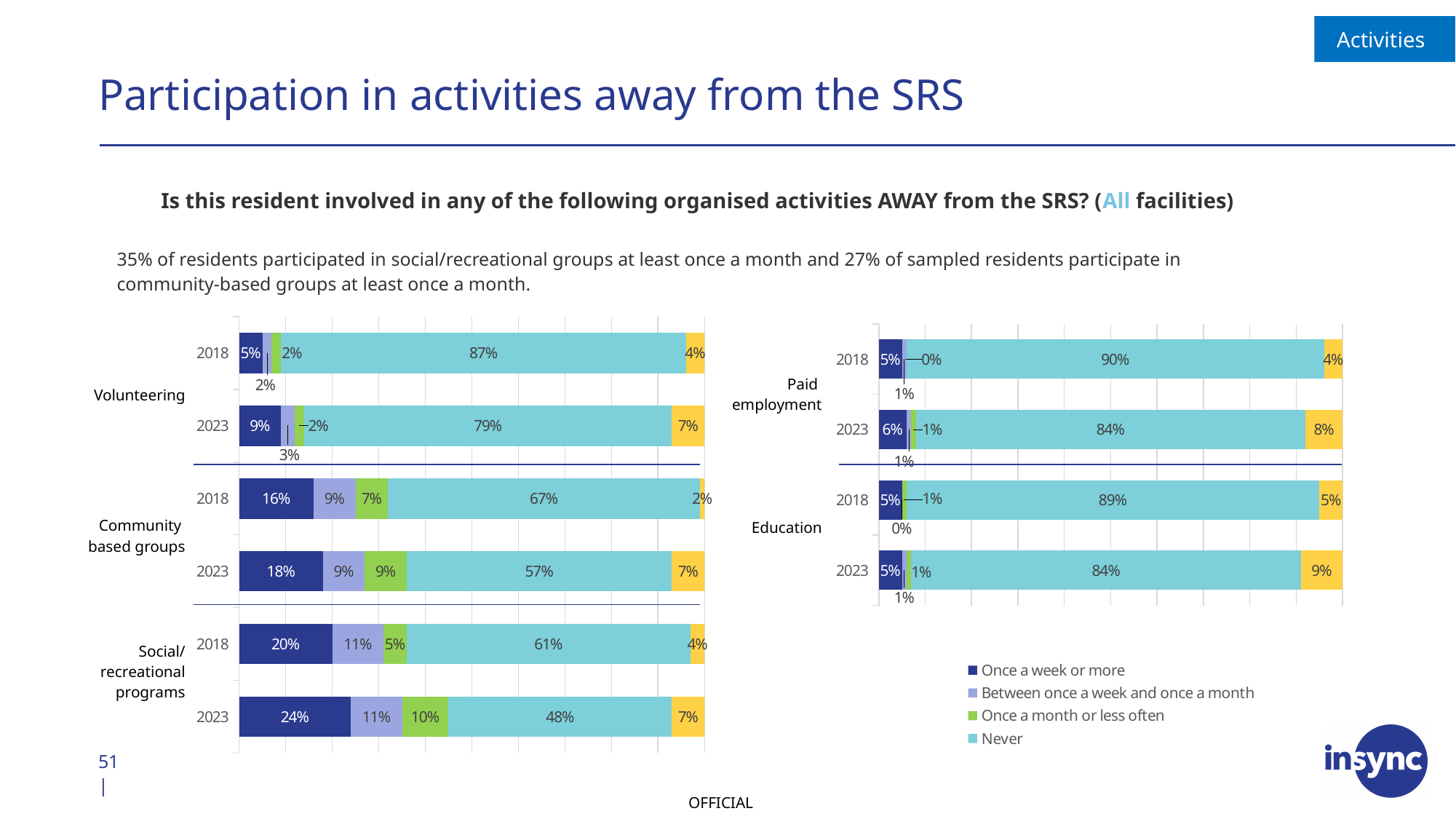
In the left chart, which activity and year has the highest 'Once a week or more' value? Social/recreational programs, 2023 In the left chart, by how many percentage points did the 'Never' value for Volunteering fall from 2018 to 2023? 8 percentage points In the left chart, which activity and year has the lowest 'Never' value? Social/recreational programs, 2023 How many activity categories are shown in the left chart? 3 In the left chart, what percentage of residents were recorded as 'Never' for Social/recreational programs in 2023? 48% What kind of chart is used on this slide? Stacked bar chart In the right chart, which has the larger 'Never' value in 2018: Paid employment or Education? Paid employment In the right chart, what is the 'Once a week or more' value for Paid employment in 2023? 6% In the left chart, what is the 'Once a week or more' value for Community based groups in 2023? 18% In the right chart, what is the 'Never' value for Paid employment in 2018? 90% How many series does the legend list? 4 In the left chart, did the 'Once a week or more' value for Social/recreational programs rise or fall from 2018 to 2023? Rise